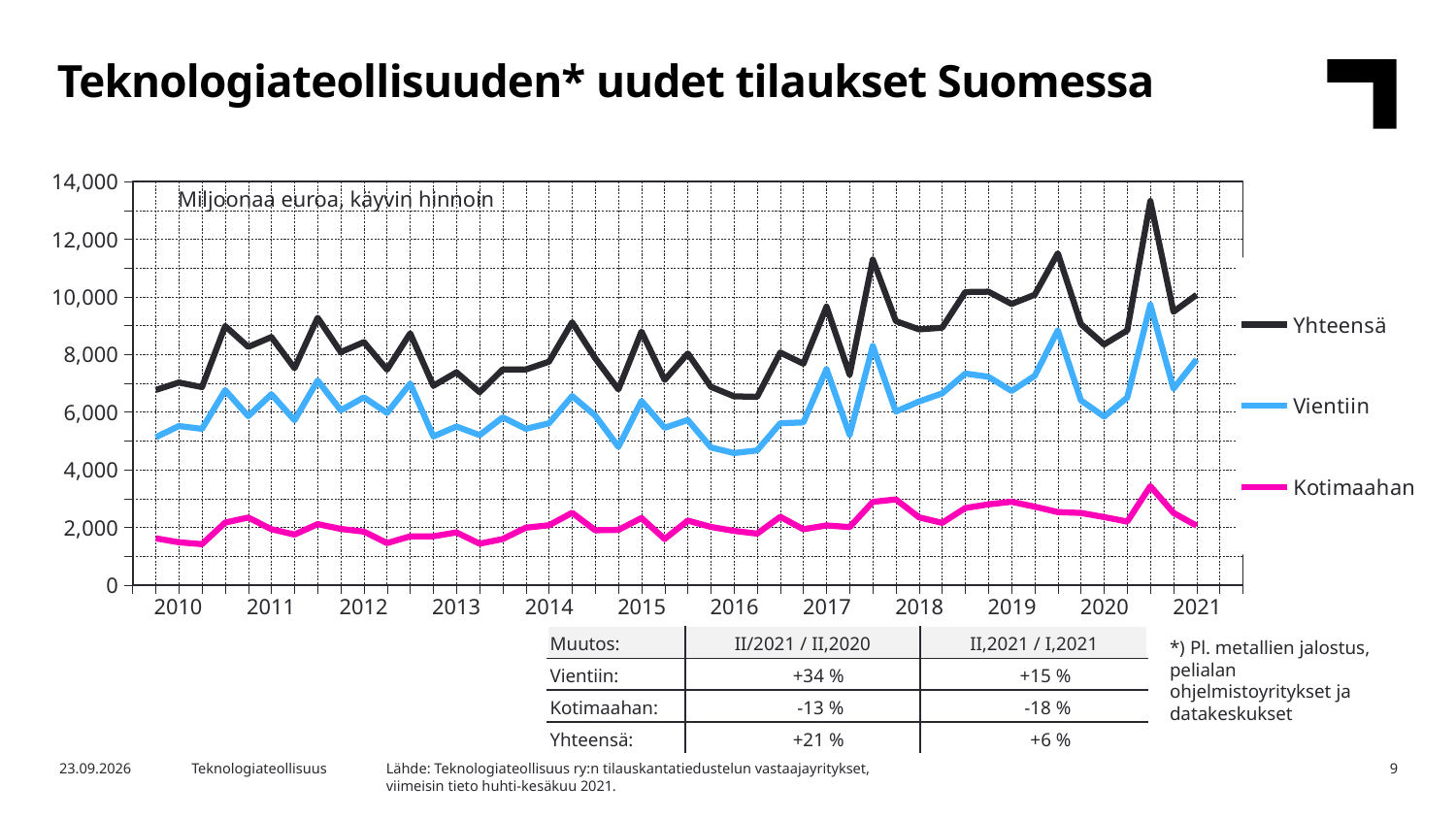
Is the peak value of the Yhteensä line in 2020 greater or less than 12,000? greater What type of chart is shown on the slide? line chart What unit is stated in the chart's plot area? Miljoonaa euroa, käyvin hinnoin Which series is larger in 2019, Vientiin or Kotimaahan? Vientiin Is the peak value of the Vientiin line in 2020 greater or less than 8,000? greater Is the lowest value of the Vientiin line in 2016 greater or less than 6,000? less Which series has the lowest values throughout the chart? Kotimaahan Does the Yhteensä line generally rise or fall from 2016 to 2021? rise Which series has the highest values throughout the chart? Yhteensä Which series is plotted with the black line? Yhteensä How many series does the legend list? 3